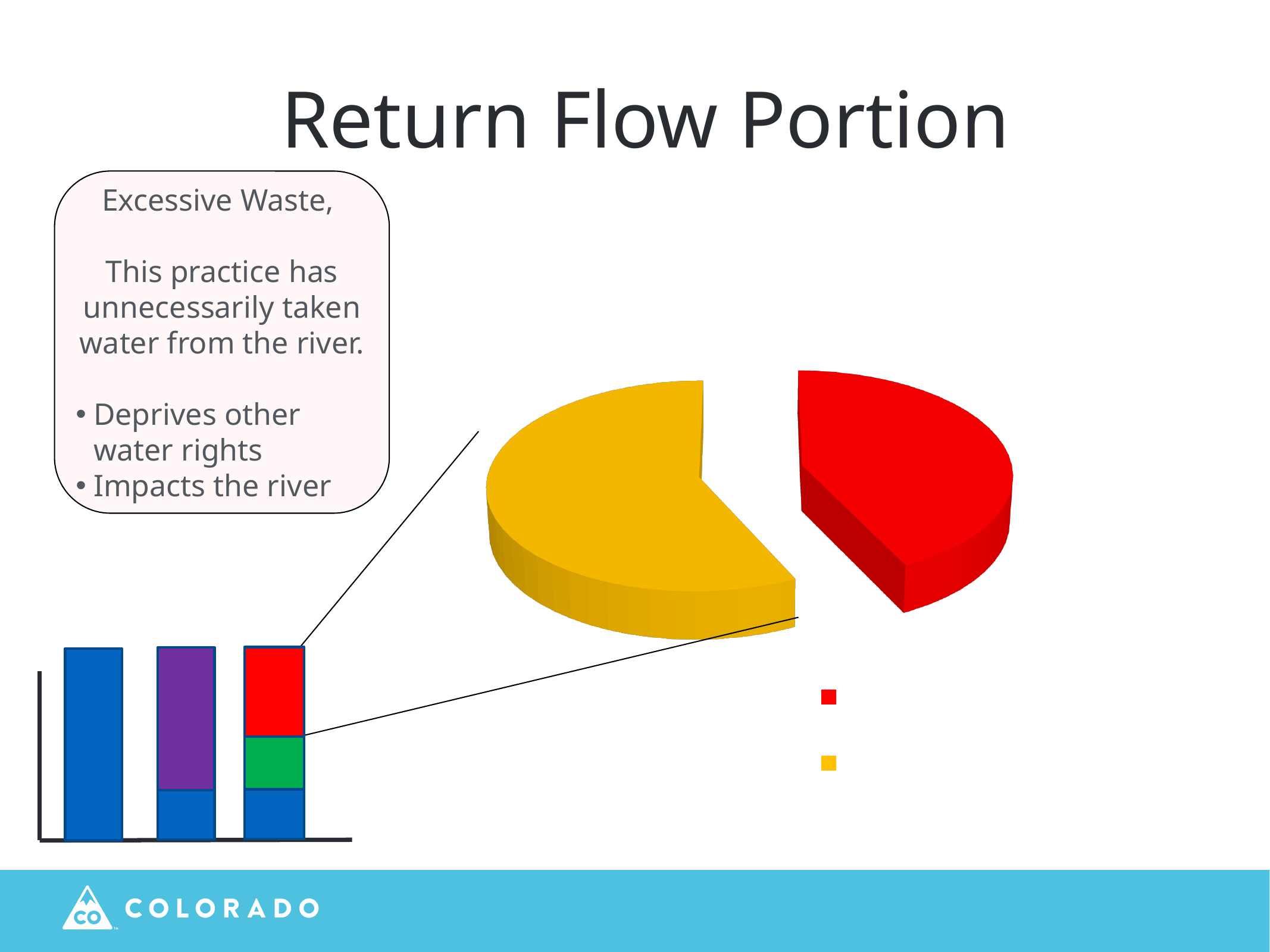
What kind of chart is shown in the bottom-left corner of the slide? bar chart How many bars does the bar chart in the bottom-left corner have? 3 In the bar chart in the bottom-left corner, how many coloured segments make up the rightmost bar? 3 How many entries does the legend of the pie chart on the right show? 2 What kind of chart is the large chart on the right of the slide? pie chart How many slices does the pie chart on the right have? 2 What two colours are used for the slices of the pie chart on the right? yellow and red In the pie chart on the right, which slice is larger, the yellow one or the red one? yellow In the pie chart on the right, which slice is the smallest? the red slice